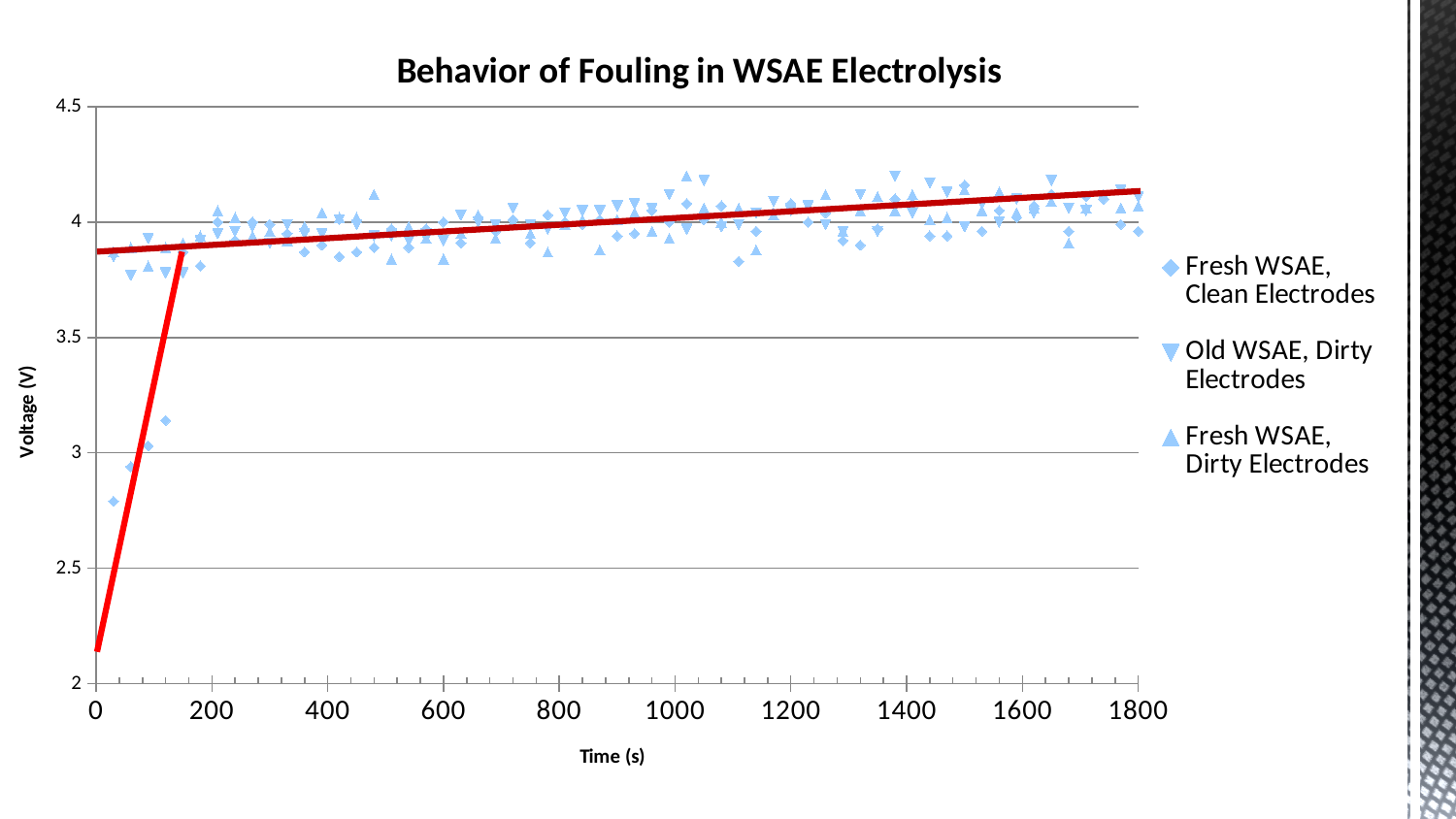
Are the voltage values of all three series at around 1800 s greater or less than 3.5? greater Is the voltage of the first Fresh WSAE, Clean Electrodes point (near 20 s) greater or less than 3? less What is the title of the chart? Behavior of Fouling in WSAE Electrolysis How many series does the chart legend list? 3 Are the plotted voltages between 400 s and 1800 s greater or less than 2.5? greater What is the label of the vertical axis? Voltage (V) What is the maximum value shown on the Time (s) axis? 1800 What kind of chart is shown on the slide? Scatter chart Does the voltage generally rise or fall as time increases from 200 s to 1800 s? Rise